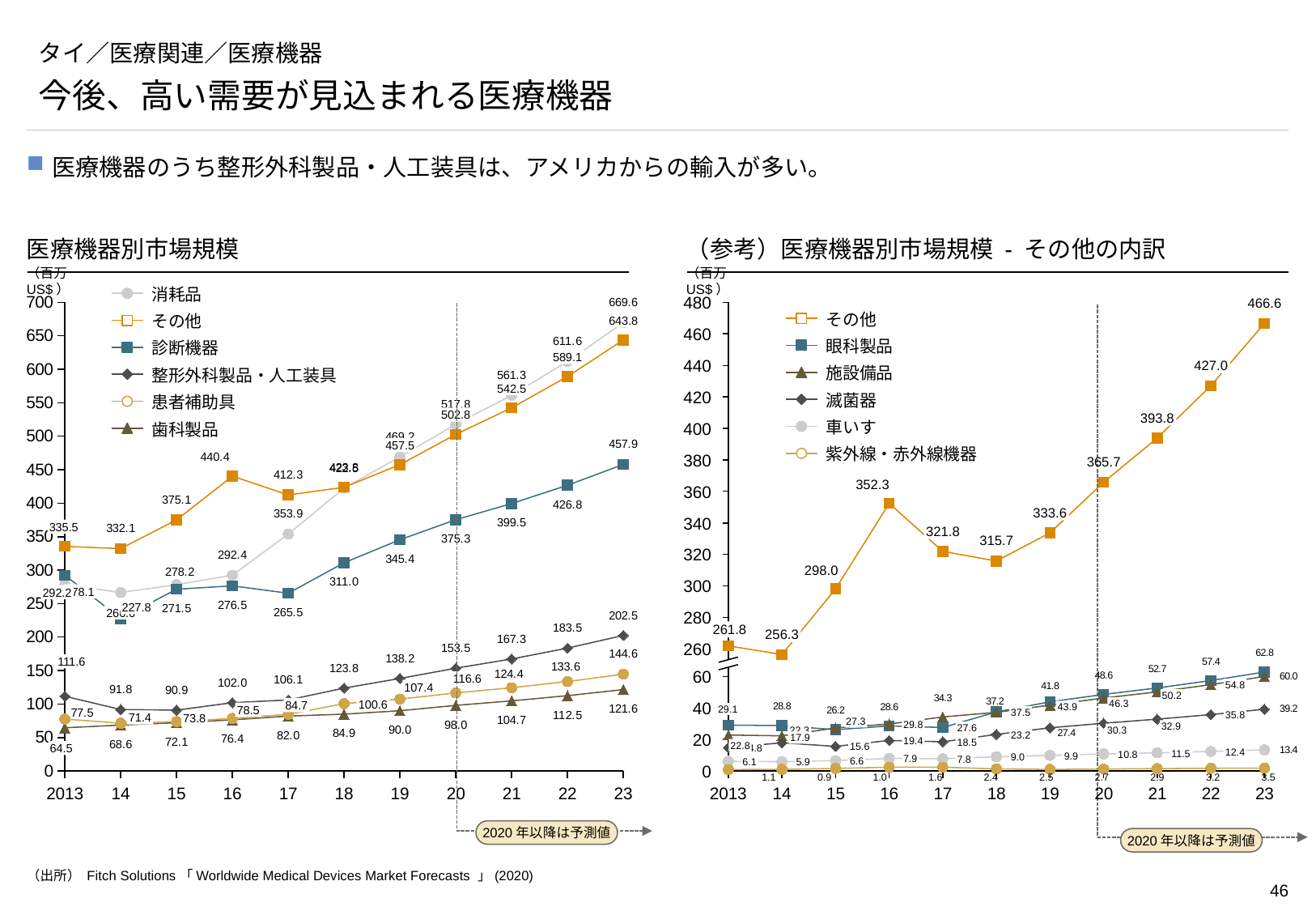
In the right chart （参考）医療機器別市場規模 - その他の内訳, how many years are plotted along the x axis? 11 What kind of chart is the left chart titled 医療機器別市場規模? line chart In the left chart 医療機器別市場規模, how many series does the legend list? 6 In the right chart （参考）医療機器別市場規模 - その他の内訳, what is the value for その他 in 2023? 466.6 In the left chart 医療機器別市場規模, by how much did 整形外科製品・人工装具 increase from 2013 (111.6) to 2023 (202.5)? 90.9 In the left chart 医療機器別市場規模, which series has the highest value in 2023? 消耗品 In the left chart 医療機器別市場規模, what is the value for その他 in 2016? 440.4 In the left chart 医療機器別市場規模, which series has the lowest value in 2023? 歯科製品 In the left chart 医療機器別市場規模, what is the value for 診断機器 in 2023? 457.9 In the right chart （参考）医療機器別市場規模 - その他の内訳, what is the value for 眼科製品 in 2023? 62.8 In the left chart 医療機器別市場規模, what is the value for 消耗品 in 2023? 669.6 In the right chart （参考）医療機器別市場規模 - その他の内訳, does the value for その他 rise or fall from 2020 to 2023? rise